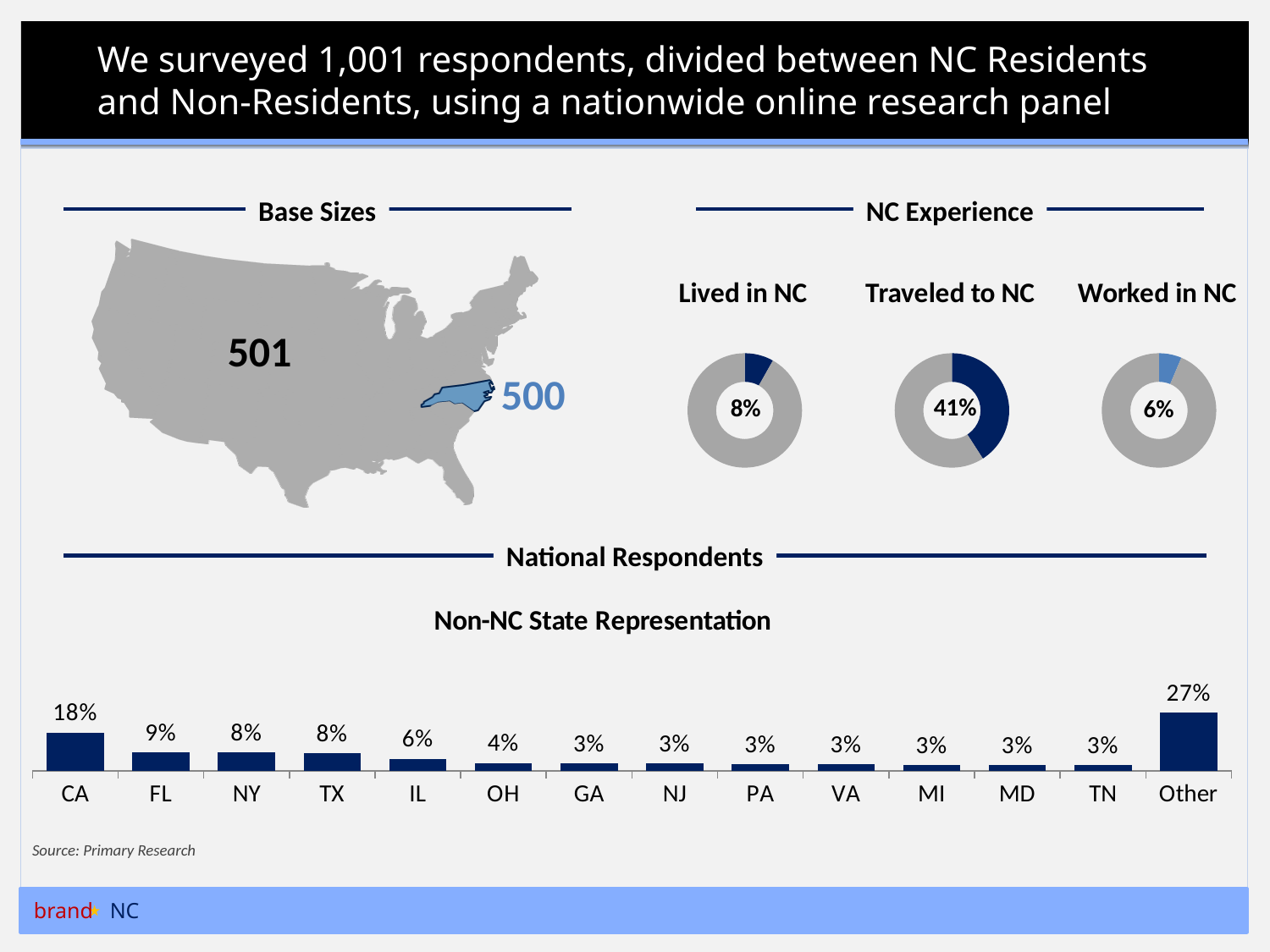
In the Lived in NC donut chart, what percentage is shown? 8% In the Traveled to NC donut chart, what percentage is shown? 41% What kind of chart is the Non-NC State Representation chart? Bar chart In the Non-NC State Representation chart, what is the value for CA? 18% In the Non-NC State Representation chart, which is larger, the value for TX or the value for OH? TX In the Non-NC State Representation chart, which category has the highest value? Other In the Non-NC State Representation chart, what is the value for IL? 6% Among the three NC Experience donut charts, which has the lowest percentage? Worked in NC How many categories are shown in the Non-NC State Representation chart? 14 In the Non-NC State Representation chart, what is the difference between the values for CA and FL? 9% In the Non-NC State Representation chart, which state (excluding Other) has the highest value? CA What is the difference between the Traveled to NC percentage and the Worked in NC percentage? 35%